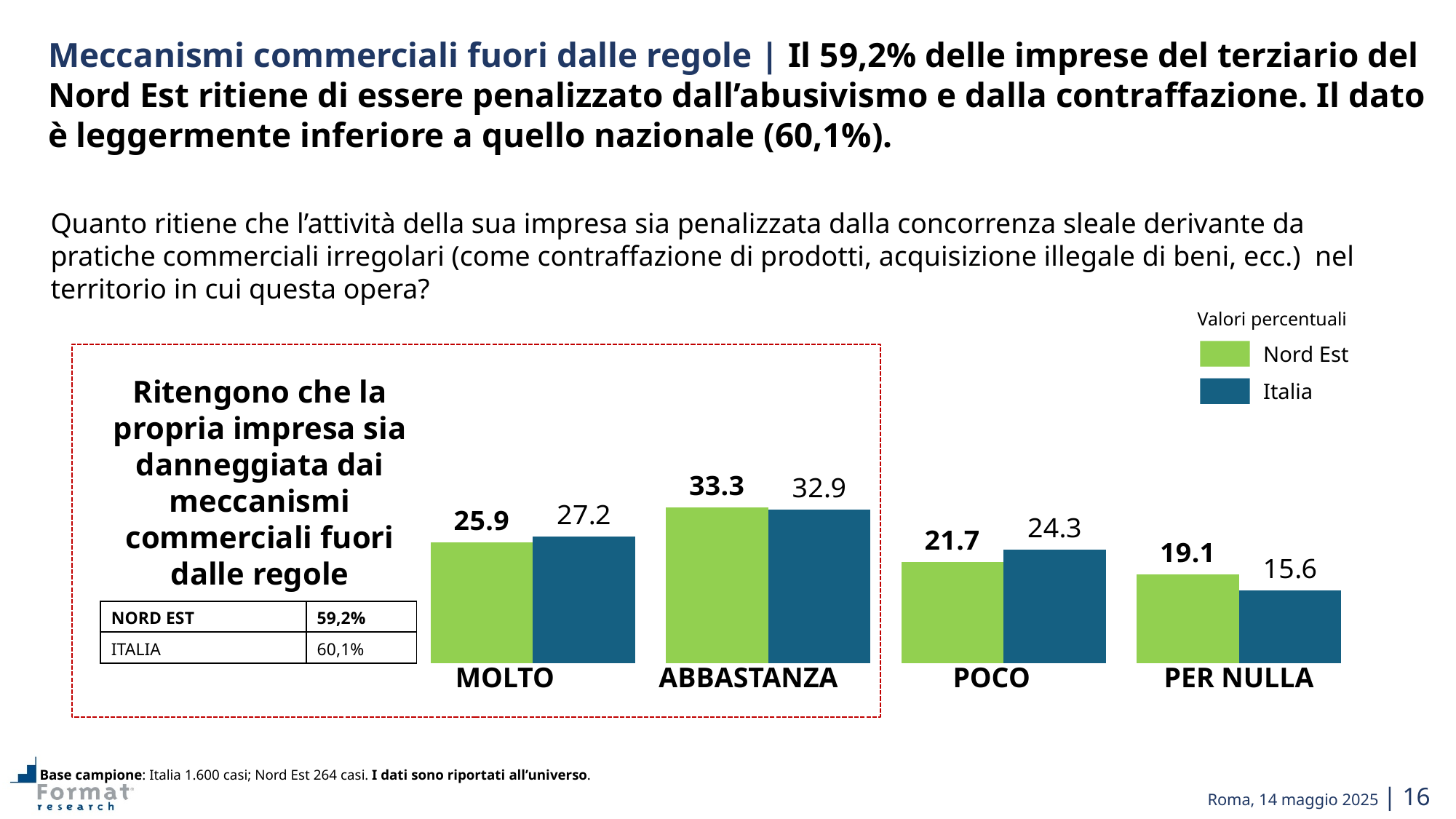
How many categories are shown on the x axis of the chart? 4 What kind of chart is shown on the slide? Bar chart How many series does the legend list? 2 What is the Nord Est value for PER NULLA? 19.1 What is the Italia value for ABBASTANZA? 32.9 What is the difference between the Italia and Nord Est values for POCO? 2.6 Which colour represents the Italia series in the chart? Blue Which category has the lowest Italia value? PER NULLA What is the Nord Est value for MOLTO? 25.9 Which is larger for PER NULLA, the Nord Est value or the Italia value? Nord Est Which category has the highest Nord Est value? ABBASTANZA What is the Italia value for POCO? 24.3